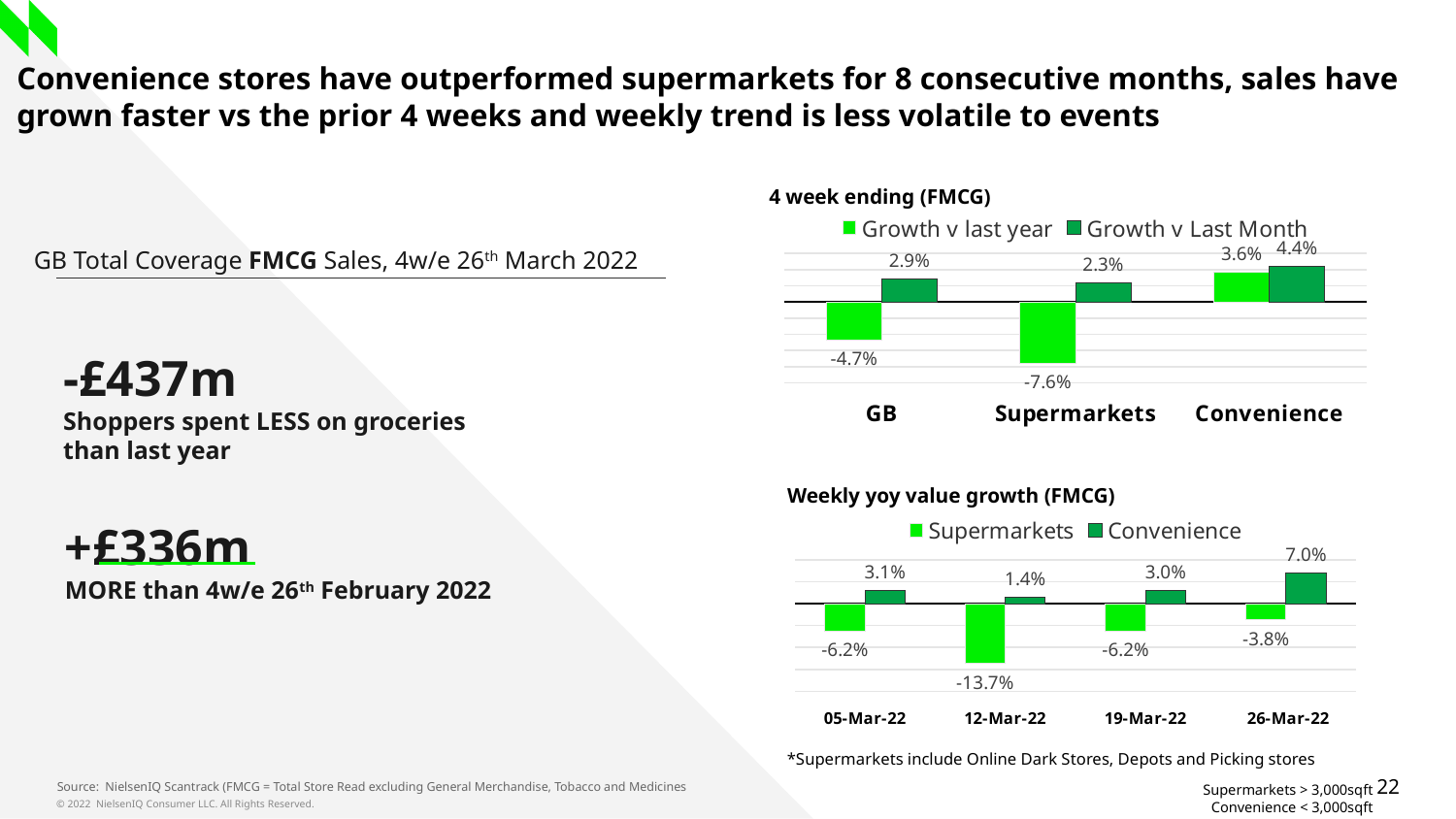
In the 'Weekly yoy value growth (FMCG)' chart, what is the Convenience value for 26-Mar-22? 7.0% In the '4 week ending (FMCG)' chart, what is the Growth v last year value for Supermarkets? -7.6% In the 'Weekly yoy value growth (FMCG)' chart, what is the Supermarkets value for 12-Mar-22? -13.7% In the '4 week ending (FMCG)' chart, which category has the lowest Growth v last year value? Supermarkets In the 'Weekly yoy value growth (FMCG)' chart, which week has the highest Convenience value? 26-Mar-22 In the '4 week ending (FMCG)' chart, how many series does the legend list? 2 In the '4 week ending (FMCG)' chart, what is the Growth v Last Month value for Convenience? 4.4% In the 'Weekly yoy value growth (FMCG)' chart, is the Convenience value for 19-Mar-22 larger than the Convenience value for 12-Mar-22? Yes What type of chart is the '4 week ending (FMCG)' chart? Bar chart In the 'Weekly yoy value growth (FMCG)' chart, how many weeks are shown on the x axis? 4 In the '4 week ending (FMCG)' chart, what is the difference between the Growth v last year values for Convenience and GB? 8.3 percentage points In the 'Weekly yoy value growth (FMCG)' chart, what is the difference between the Convenience and Supermarkets values for 05-Mar-22? 9.3 percentage points